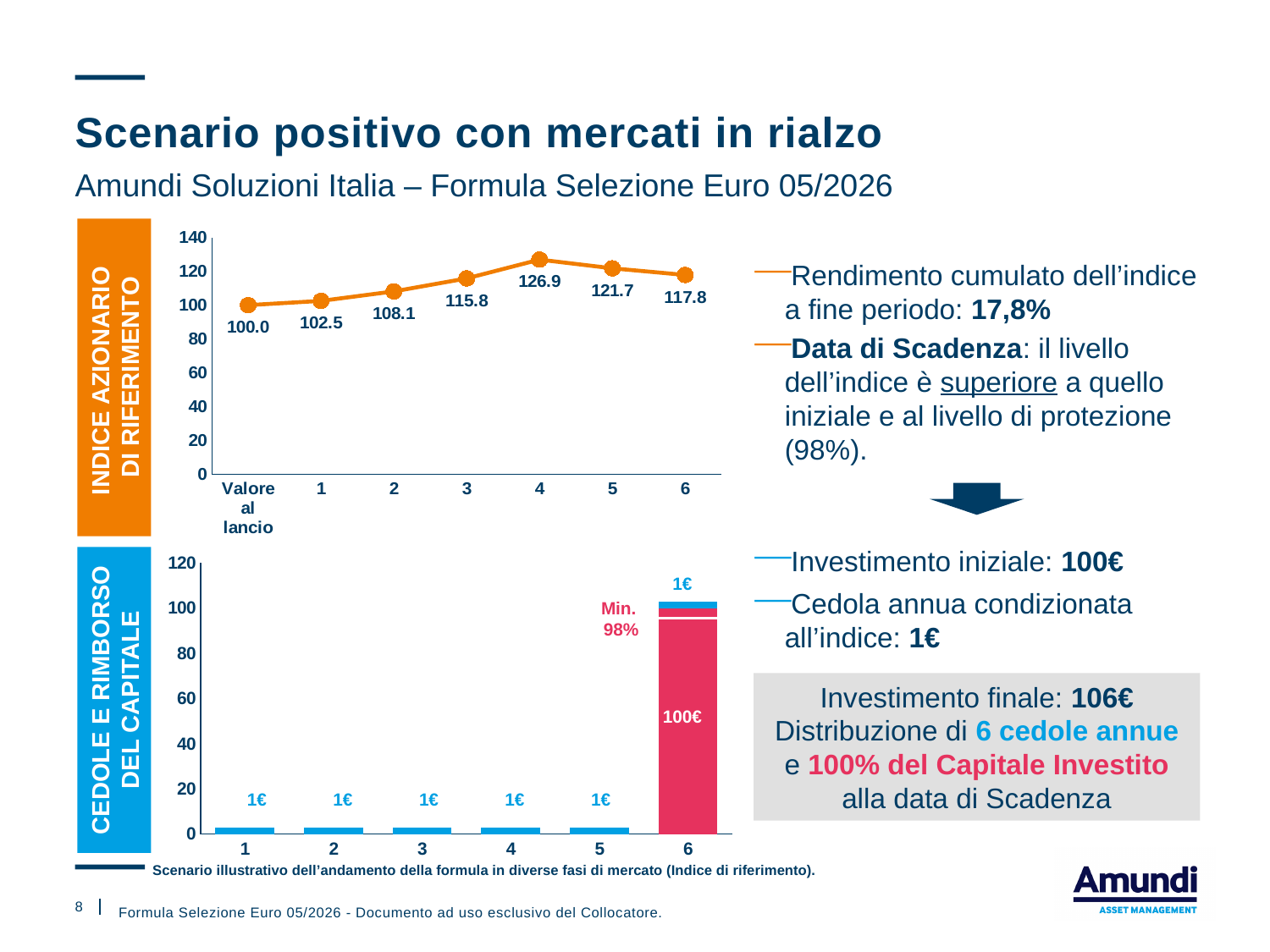
In the top chart (INDICE AZIONARIO DI RIFERIMENTO), what is the difference between the index value at year 4 and at year 5? 5.2 In the bottom chart (CEDOLE E RIMBORSO DEL CAPITALE), what is the value of the large pink segment at year 6? 100€ In the top chart (INDICE AZIONARIO DI RIFERIMENTO), what is the index value at 'Valore al lancio'? 100.0 What type of chart is the bottom chart (CEDOLE E RIMBORSO DEL CAPITALE)? Bar chart In the top chart (INDICE AZIONARIO DI RIFERIMENTO), which point has the lowest index value? Valore al lancio In the bottom chart (CEDOLE E RIMBORSO DEL CAPITALE), what is the value of the coupon bar at year 3? 1€ In the top chart (INDICE AZIONARIO DI RIFERIMENTO), which is larger: the value at year 3 or the value at year 6? Year 6 In the top chart (INDICE AZIONARIO DI RIFERIMENTO), at which year is the index value highest? 4 In the top chart (INDICE AZIONARIO DI RIFERIMENTO), what is the index value at year 6? 117.8 What type of chart is the top chart (INDICE AZIONARIO DI RIFERIMENTO)? Line chart In the top chart (INDICE AZIONARIO DI RIFERIMENTO), how many data points are plotted on the line? 7 In the top chart (INDICE AZIONARIO DI RIFERIMENTO), what is the index value at year 4? 126.9